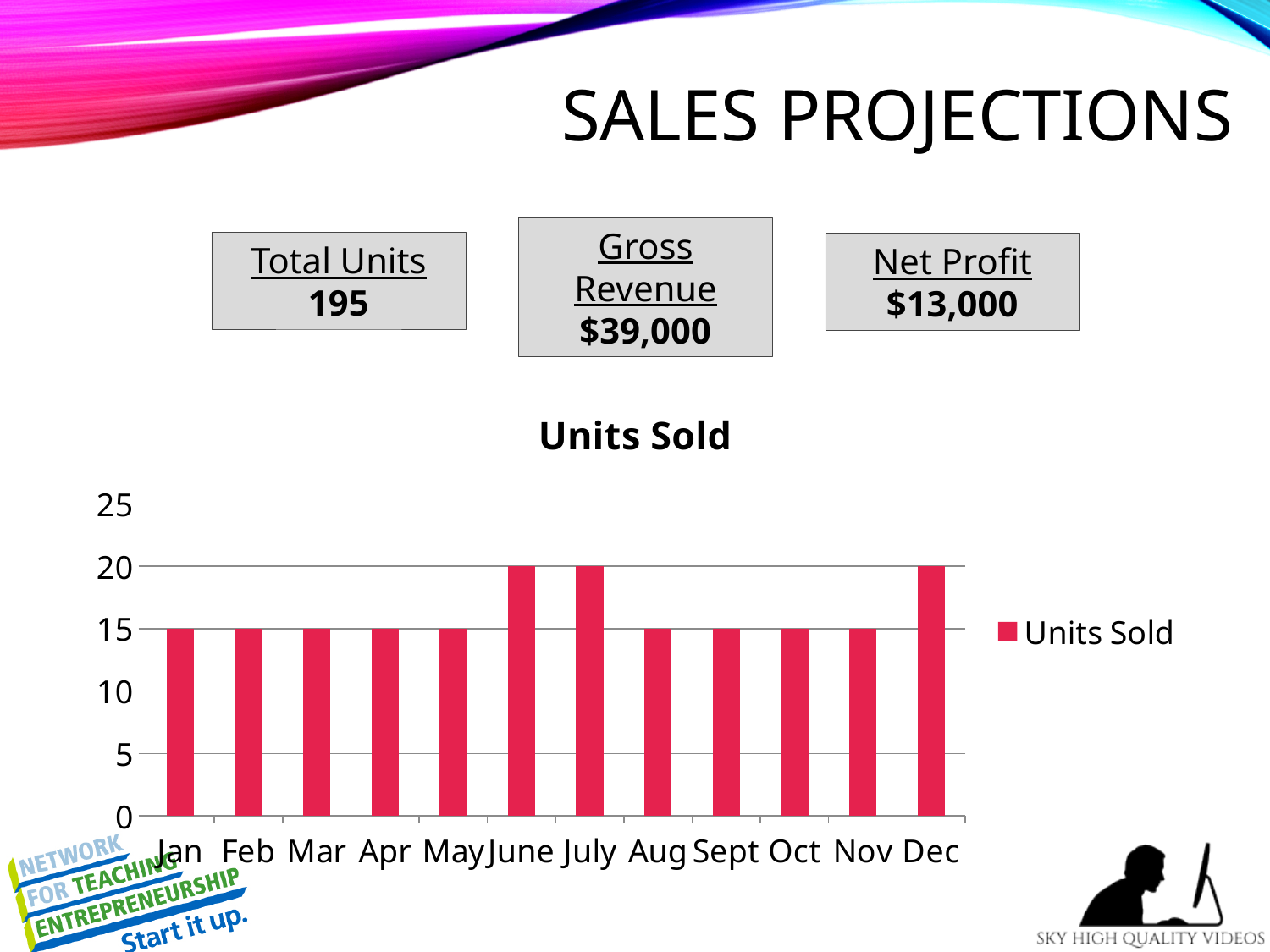
What is the title of the chart? Units Sold What is the highest value plotted in the Units Sold chart? 20 What is the lowest value plotted in the Units Sold chart? 15 What is the difference between the values for July and Aug? 5 Is the value for Mar greater or less than 20? less What is the value for June in the Units Sold chart? 20 What is the value for Jan in the Units Sold chart? 15 What type of chart is shown on the slide? Bar chart How many months are shown on the x axis of the chart? 12 What is the value for Dec in the Units Sold chart? 20 Which month has the larger value, May or June? June How many series does the chart's legend list? 1